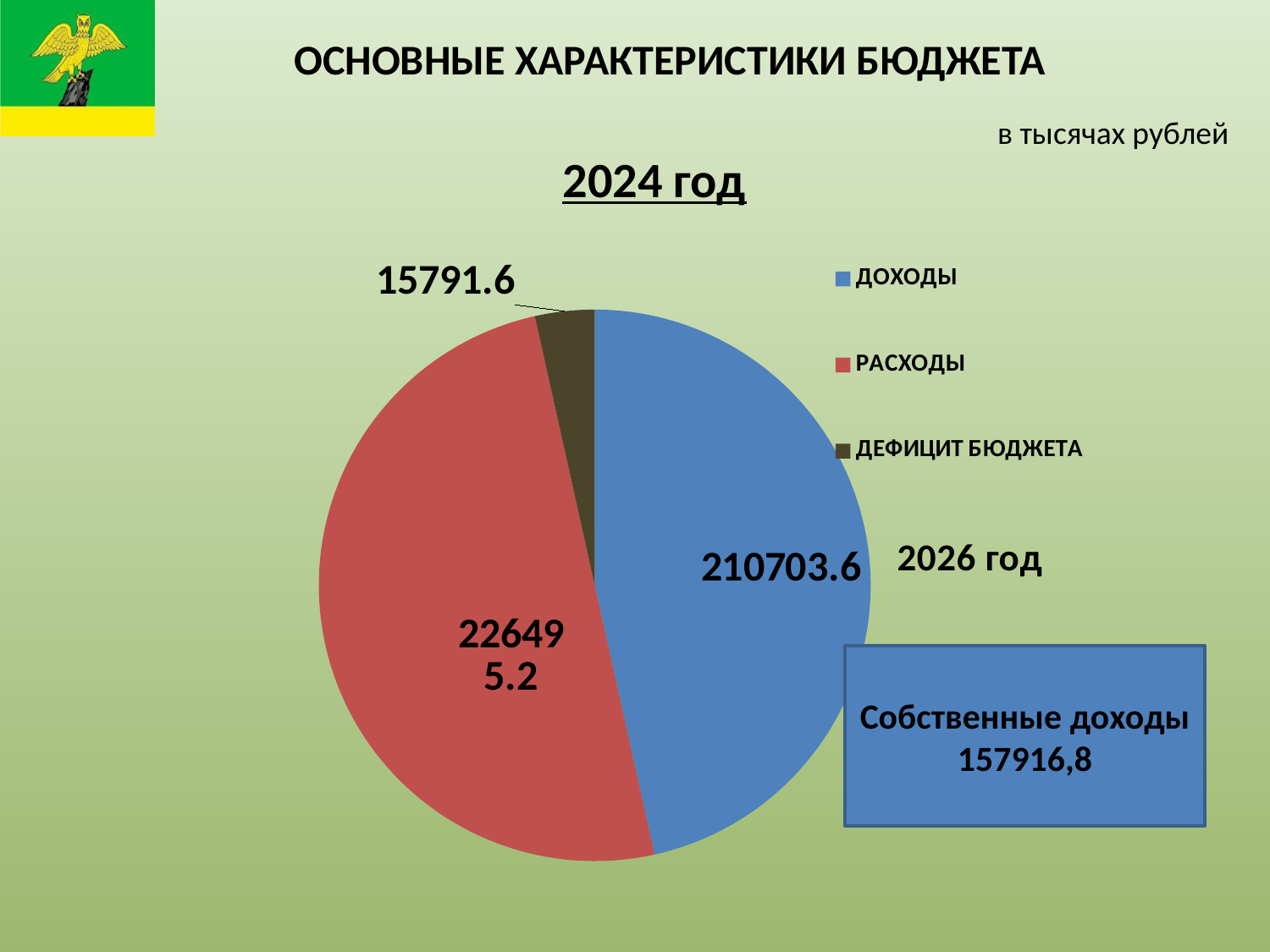
How many entries does the legend list? 3 How many slices does the pie chart have? 3 Which year does the pie chart heading refer to? 2024 год What colour is the ДОХОДЫ slice in the pie chart? Blue Which is larger, ДОХОДЫ or РАСХОДЫ? РАСХОДЫ What is the value for ДОХОДЫ in the pie chart? 210703.6 Which category has the largest slice in the pie chart? РАСХОДЫ Which category has the smallest slice in the pie chart? ДЕФИЦИТ БЮДЖЕТА What is the difference between РАСХОДЫ and ДОХОДЫ? 15791.6 What is the value for РАСХОДЫ in the pie chart? 226495.2 What kind of chart is shown on the slide? Pie chart What is the value for ДЕФИЦИТ БЮДЖЕТА in the pie chart? 15791.6